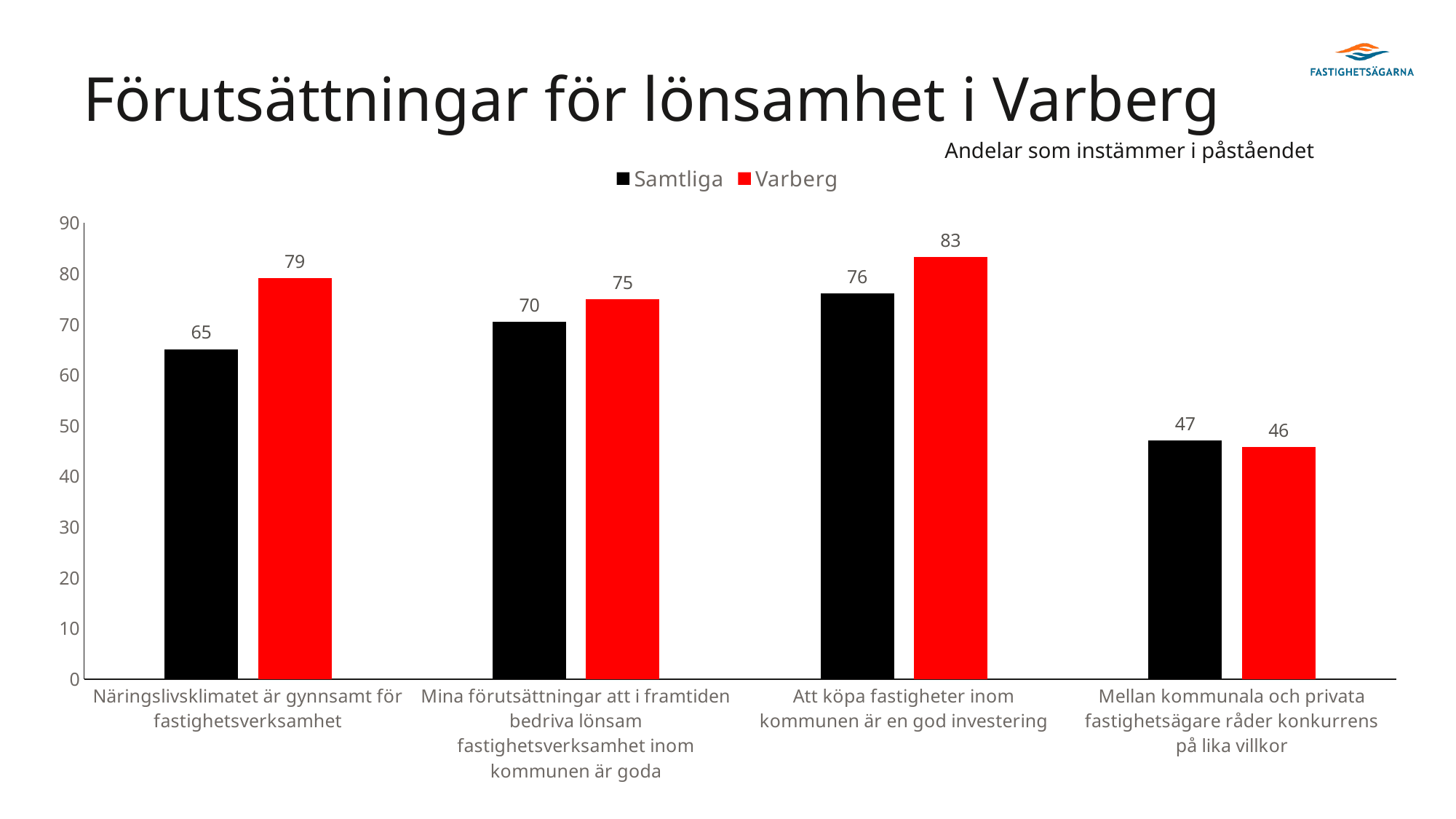
How many categories are shown on the x axis? 4 Which colour represents the Varberg series? Red What is the difference between the Varberg and Samtliga values for "Näringslivsklimatet är gynnsamt för fastighetsverksamhet"? 14 Is the Samtliga value for "Att köpa fastigheter inom kommunen är en god investering" greater or less than 70? greater What is the Varberg value for "Att köpa fastigheter inom kommunen är en god investering"? 83 For "Mina förutsättningar att i framtiden bedriva lönsam fastighetsverksamhet inom kommunen är goda", which series has the larger value, Samtliga or Varberg? Varberg Which category has the highest Varberg value? Att köpa fastigheter inom kommunen är en god investering What is the Samtliga value for "Näringslivsklimatet är gynnsamt för fastighetsverksamhet"? 65 Which category has the lowest Samtliga value? Mellan kommunala och privata fastighetsägare råder konkurrens på lika villkor How many series does the legend list? 2 What is the Varberg value for "Mellan kommunala och privata fastighetsägare råder konkurrens på lika villkor"? 46 What kind of chart is shown on the slide? Bar chart